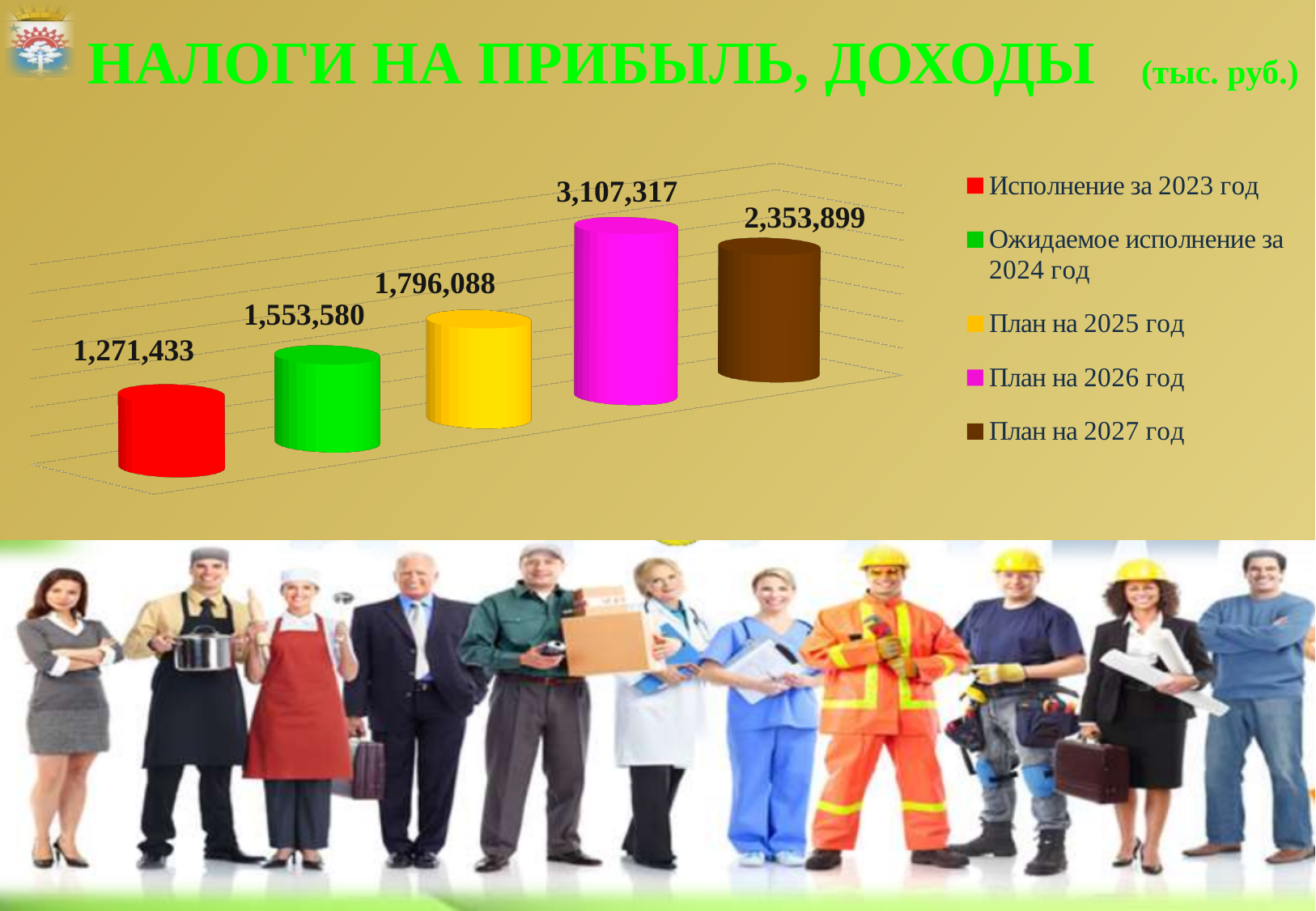
What is the value for План на 2025 год? 1,796,088 Which series has the highest value? План на 2026 год What kind of chart is shown on the slide? Bar chart What is the difference between the values for План на 2026 год and План на 2027 год? 753,418 Which series has the lowest value? Исполнение за 2023 год Which is larger, the value for План на 2027 год or the value for План на 2025 год? План на 2027 год How many series does the legend list? 5 What is the value for План на 2027 год? 2,353,899 What is the value for Ожидаемое исполнение за 2024 год? 1,553,580 What is the value for Исполнение за 2023 год? 1,271,433 Do the values rise or fall from Исполнение за 2023 год through План на 2026 год? Rise What is the difference between the values for Ожидаемое исполнение за 2024 год and Исполнение за 2023 год? 282,147